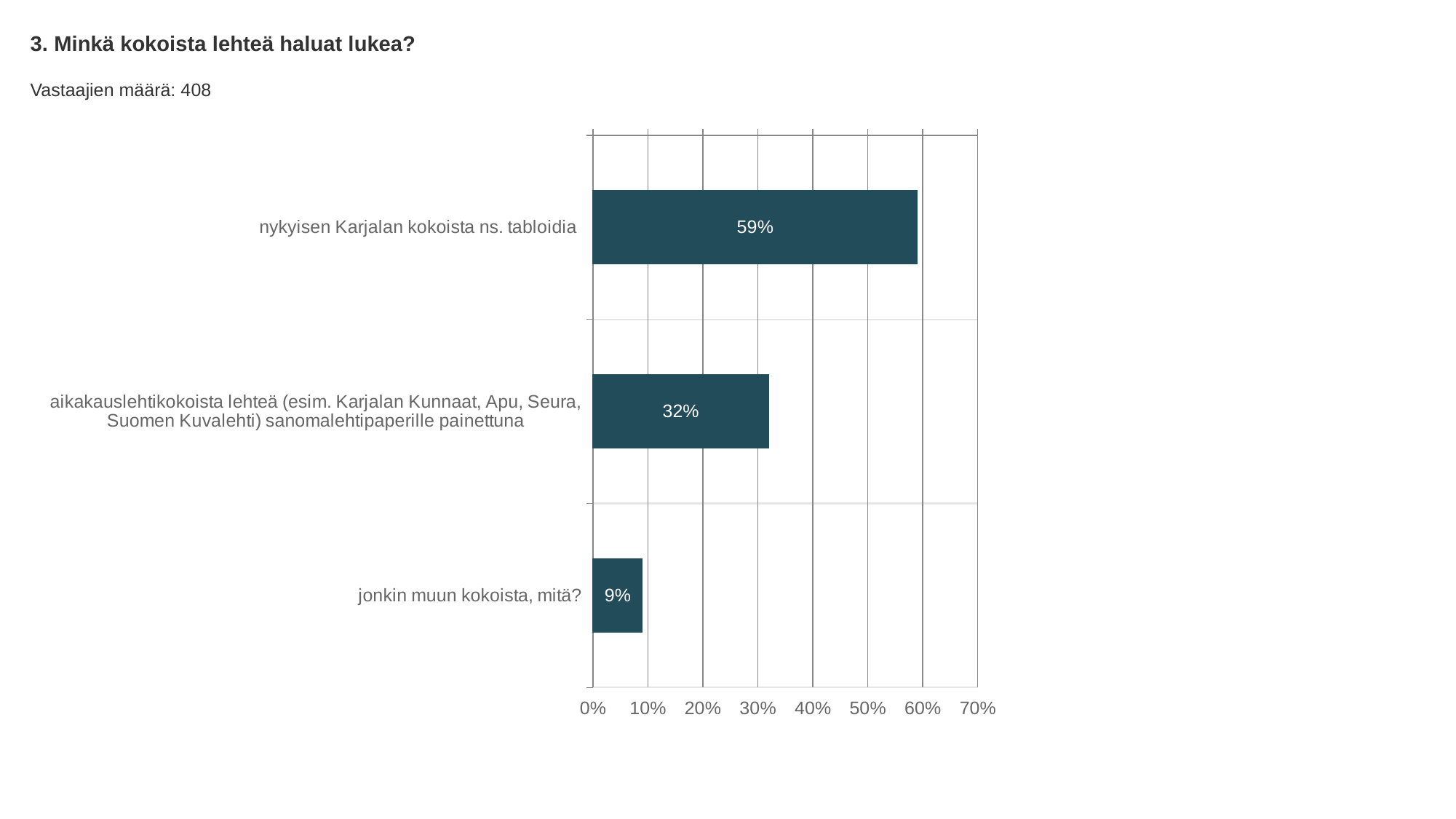
What percentage is shown for the magazine-sized option ("aikakauslehtikokoista lehteä...")? 32% How many categories are shown in the chart? 3 What percentage of respondents chose "nykyisen Karjalan kokoista ns. tabloidia"? 59% What kind of chart is shown on the slide? bar chart Which category has the highest value? nykyisen Karjalan kokoista ns. tabloidia Which category has the lowest value? jonkin muun kokoista, mitä? What is the value for "jonkin muun kokoista, mitä?"? 9% Is the value for "nykyisen Karjalan kokoista ns. tabloidia" greater or less than 50%? greater How many respondents (Vastaajien määrä) does the slide report? 408 Which is larger: the value for the magazine-sized option or the value for "jonkin muun kokoista, mitä?"? the magazine-sized option (32%) What is the difference between the tabloid option (59%) and the magazine-sized option (32%)? 27% What is the difference between the values for "nykyisen Karjalan kokoista ns. tabloidia" and "jonkin muun kokoista, mitä?"? 50%